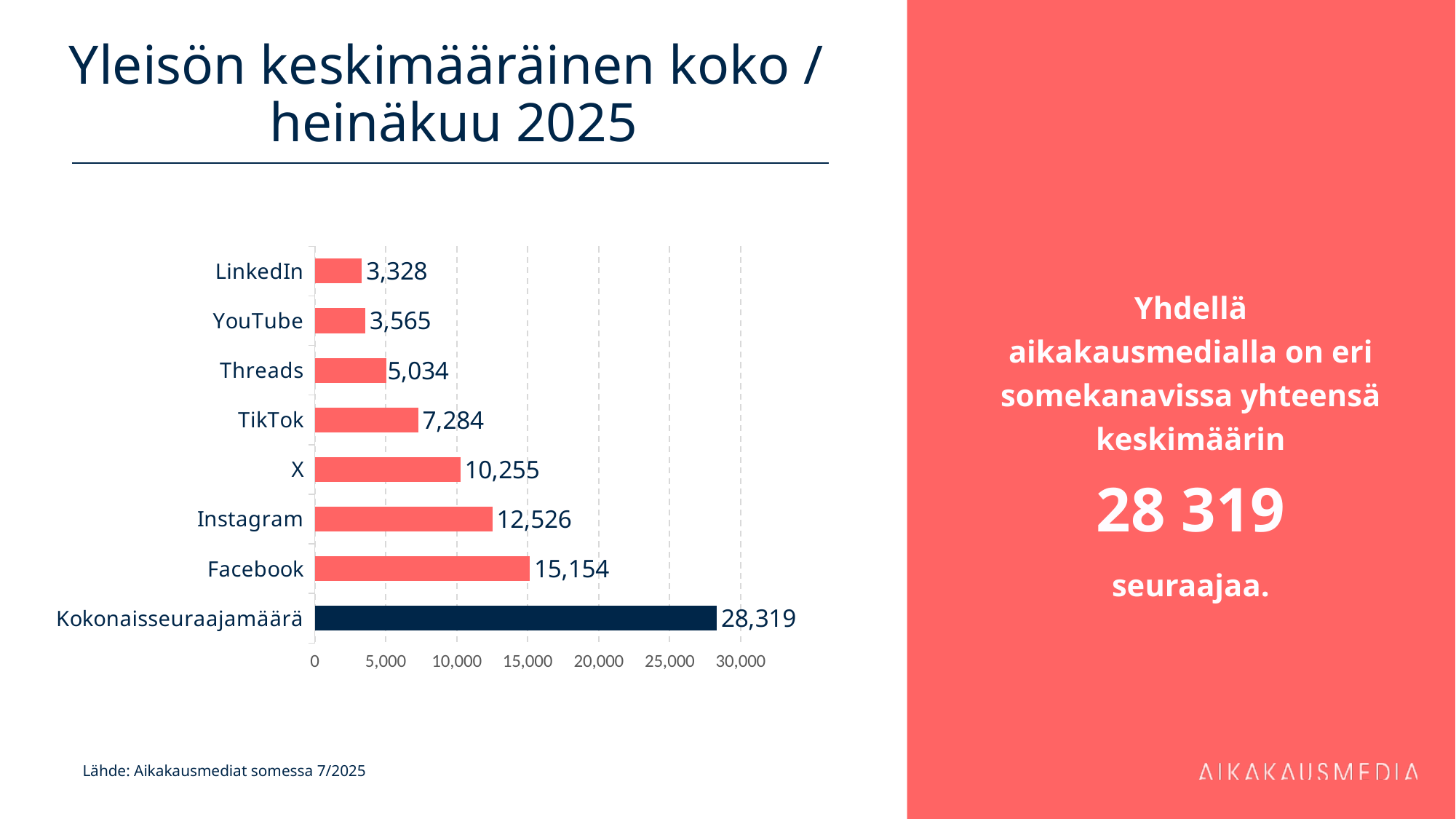
Which is larger, the value for X or the value for Threads? X What is the difference between the values for Facebook and Instagram? 2,628 What is the value for Facebook? 15,154 Which category has the highest value? Kokonaisseuraajamäärä What is the title of the slide? Yleisön keskimääräinen koko / heinäkuu 2025 Which bar is shown in a different colour (dark navy) from the others? Kokonaisseuraajamäärä Which category has the lowest value? LinkedIn What is the value for Kokonaisseuraajamäärä? 28,319 What is the value for TikTok? 7,284 How many categories are shown in the chart? 8 What kind of chart is shown on the slide? Bar chart Is the value for Instagram greater or less than 10,000? greater